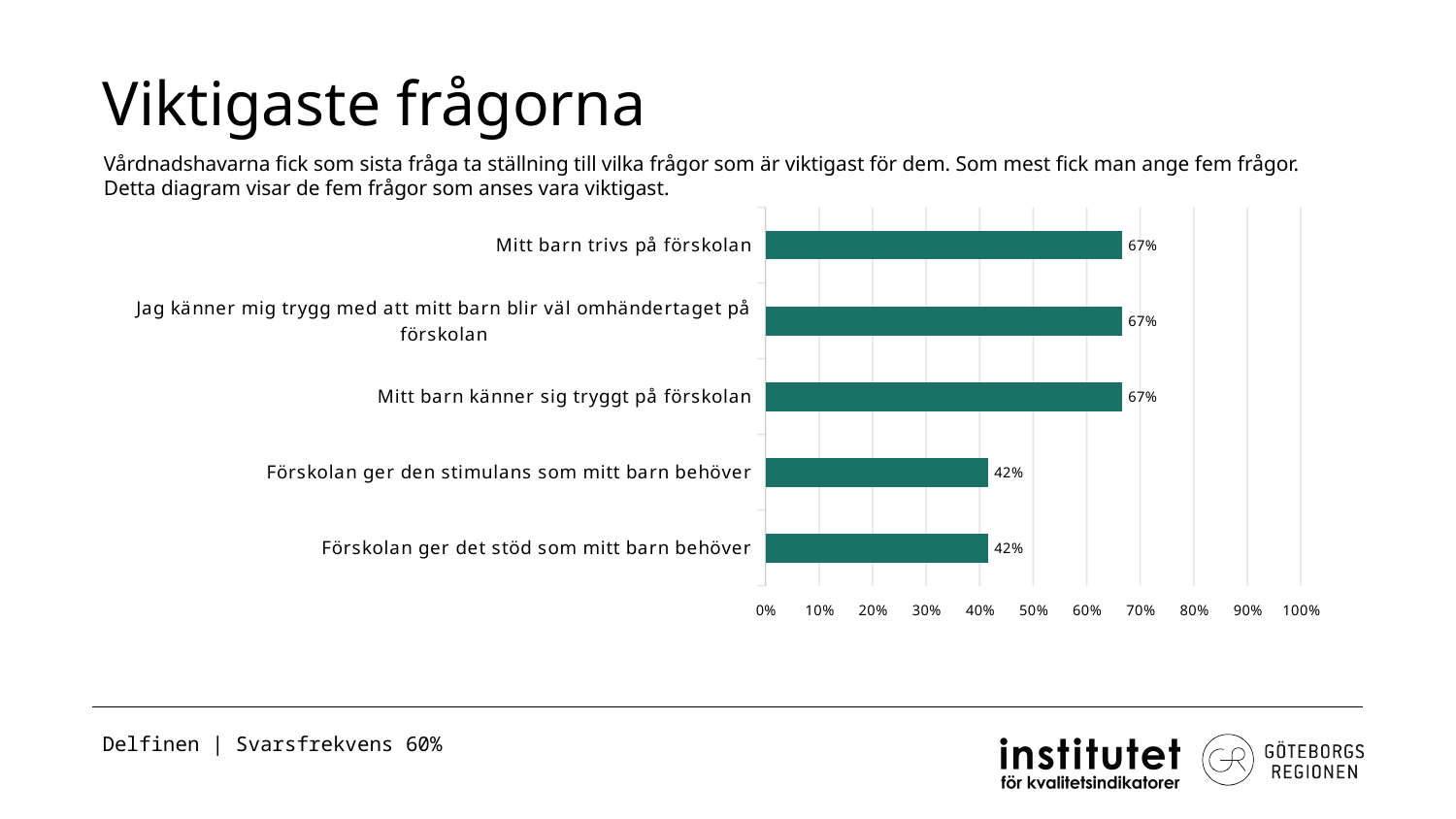
Is the value for "Mitt barn trivs på förskolan" greater or less than 60%? greater How many categories are shown in the chart? 5 What is the value for "Förskolan ger det stöd som mitt barn behöver"? 42% Is the value for "Förskolan ger det stöd som mitt barn behöver" greater or less than 50%? less What kind of chart is shown on the slide? Bar chart What is the value for "Jag känner mig trygg med att mitt barn blir väl omhändertaget på förskolan"? 67% What is the value for "Mitt barn känner sig tryggt på förskolan"? 67% What is the value for "Mitt barn trivs på förskolan"? 67% Which is larger, the value for "Mitt barn trivs på förskolan" or the value for "Förskolan ger det stöd som mitt barn behöver"? Mitt barn trivs på förskolan What is the highest value shown on the x axis of the chart? 100% What is the value for "Förskolan ger den stimulans som mitt barn behöver"? 42% What is the difference between the value for "Mitt barn känner sig tryggt på förskolan" and the value for "Förskolan ger den stimulans som mitt barn behöver"? 25 percentage points